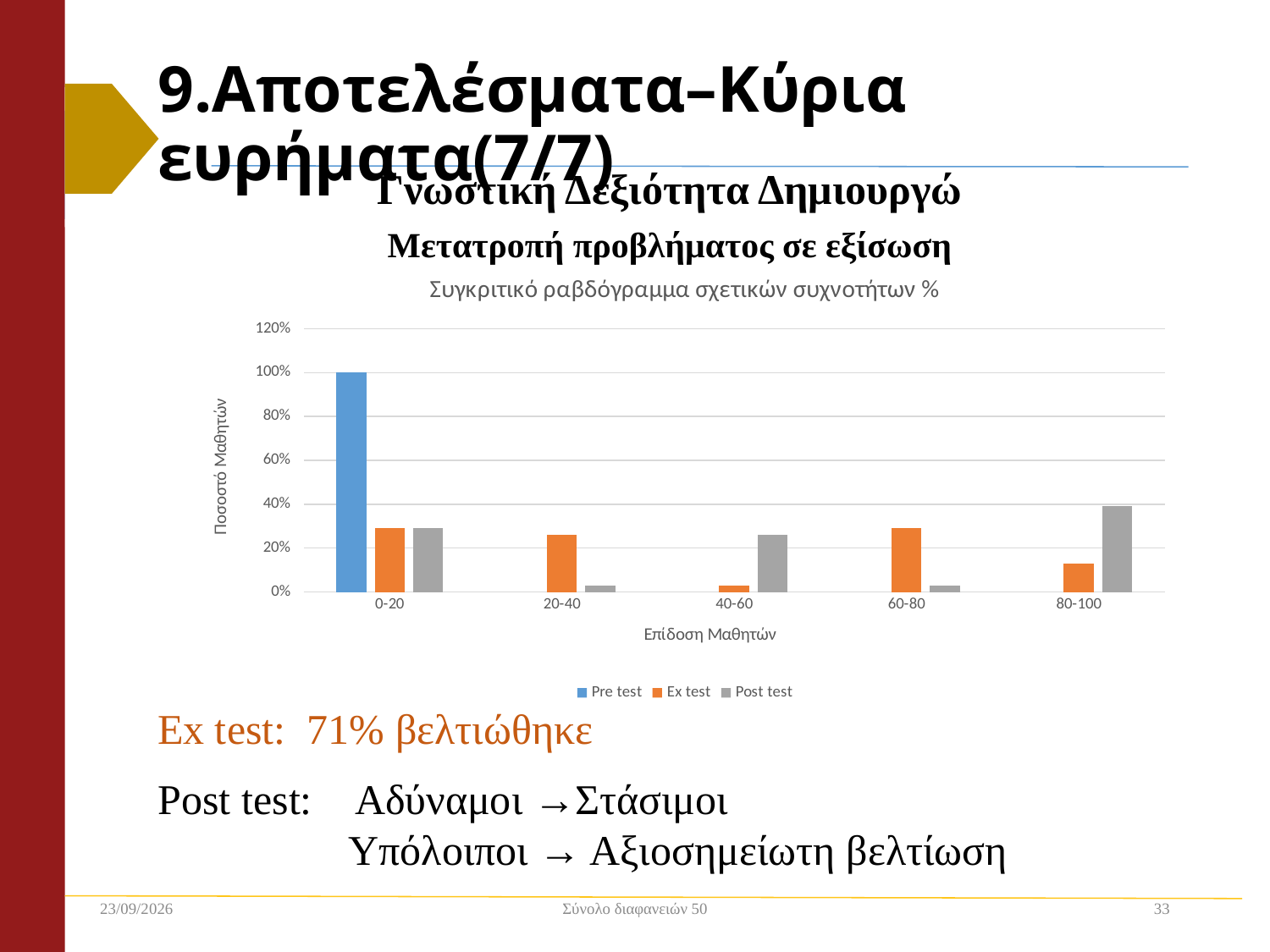
Is the Ex test value for 80-100 greater or less than 20%? less Which category has the lowest Ex test value? 40-60 What is the Pre test value for the 0-20 category? 100% Is the Post test value for 80-100 greater or less than 20%? greater In the 80-100 category, which is larger: the Ex test value or the Post test value? Post test What kind of chart is shown on the slide? bar chart In the 40-60 category, which is larger: the Ex test value or the Post test value? Post test Which category has the highest Post test value? 80-100 Is the Post test value for 20-40 greater or less than 20%? less How many series does the legend list? 3 How many score categories are shown on the x axis? 5 What is the label of the y axis? Ποσοστό Μαθητών